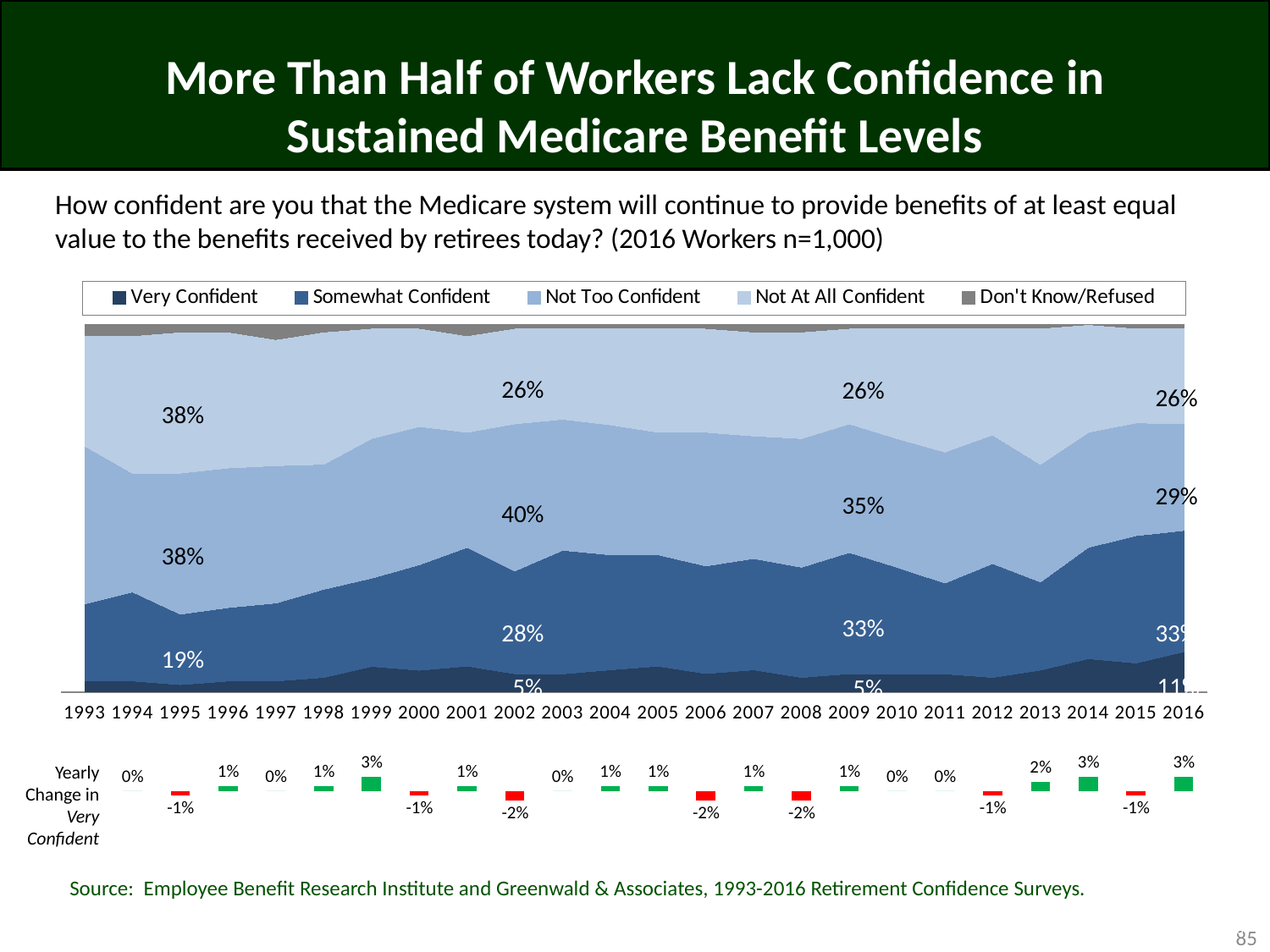
In the main chart, what percentage of workers were Very Confident in 2009? 5% How many years are shown on the x axis of the main chart? 24 In the Yearly Change in Very Confident chart, what is the value for 2014? 3% How many series does the legend of the stacked area chart list? 5 In the Yearly Change in Very Confident chart, what is the value for 2008? -2% What kind of chart is the main chart showing confidence in Medicare benefits? Stacked area chart In the main chart, what is the difference between the Not Too Confident share in 2002 and in 2016? 11% In the main chart, which is larger in 2009: the Not Too Confident share or the Somewhat Confident share? Not Too Confident In the main chart, does the Very Confident share rise or fall from 2009 to 2016? Rise In the main chart, what percentage of workers were Not At All Confident in 2016? 26% In the main chart, what percentage of workers were Not Too Confident in 2002? 40% In the main chart, what percentage of workers were Somewhat Confident in 1995? 19%